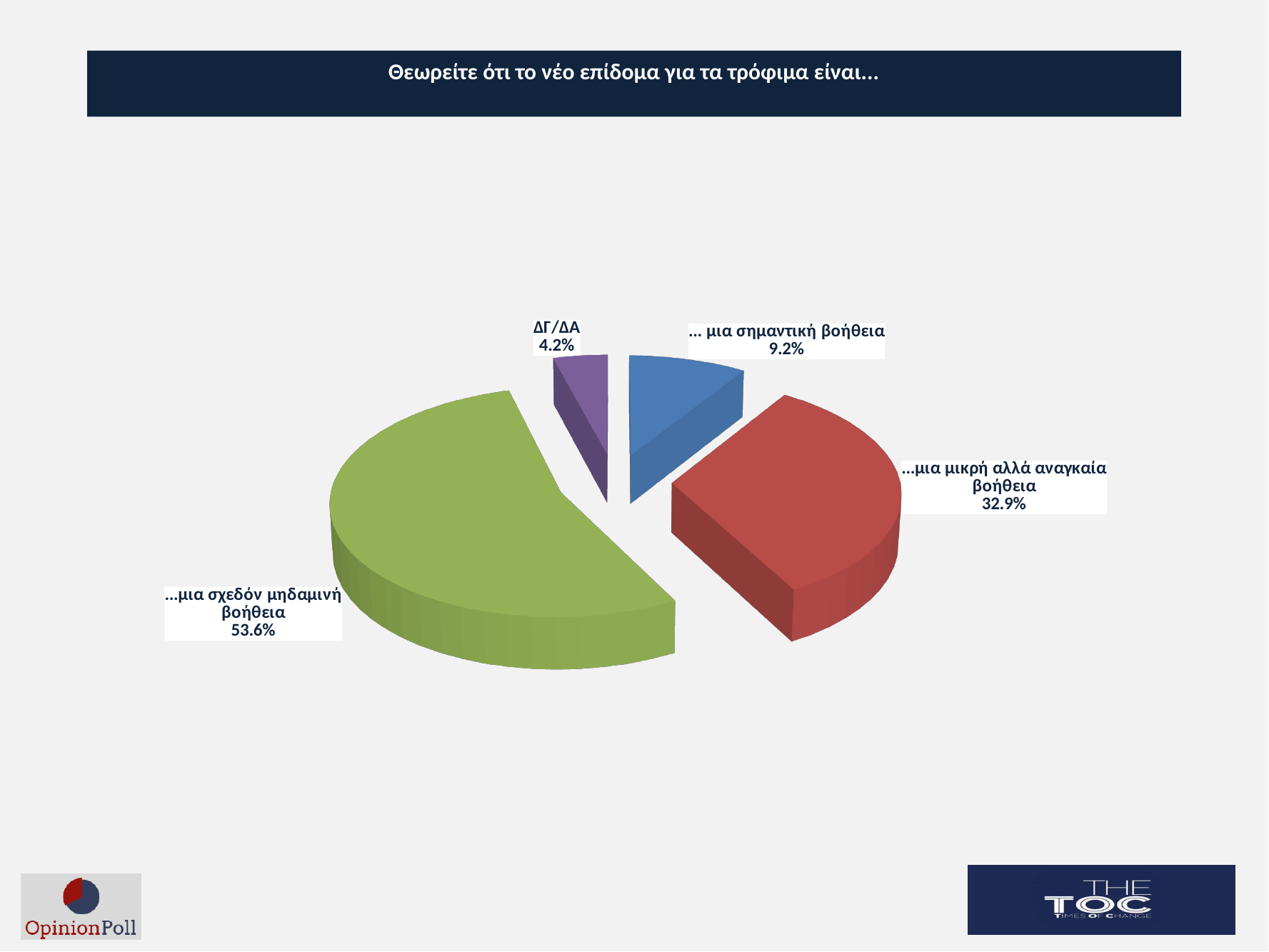
What is the difference in percentage points between "...μια σχεδόν μηδαμινή βοήθεια" and "...μια μικρή αλλά αναγκαία βοήθεια"? 20.7 What percentage of respondents answered "... μια σημαντική βοήθεια"? 9.2% What colour is the slice for "...μια μικρή αλλά αναγκαία βοήθεια"? Red What percentage of respondents answered "...μια μικρή αλλά αναγκαία βοήθεια"? 32.9% Which response has the smallest share of the pie? ΔΓ/ΔΑ What is the combined share of "... μια σημαντική βοήθεια" and "...μια μικρή αλλά αναγκαία βοήθεια"? 42.1% How many slices does the pie chart have? 4 Which response has the largest share of the pie? ...μια σχεδόν μηδαμινή βοήθεια What kind of chart is shown on the slide? Pie chart What percentage of respondents answered "ΔΓ/ΔΑ"? 4.2% What percentage of respondents answered "...μια σχεδόν μηδαμινή βοήθεια"? 53.6% Which is larger: the share for "... μια σημαντική βοήθεια" or the share for "ΔΓ/ΔΑ"? ... μια σημαντική βοήθεια